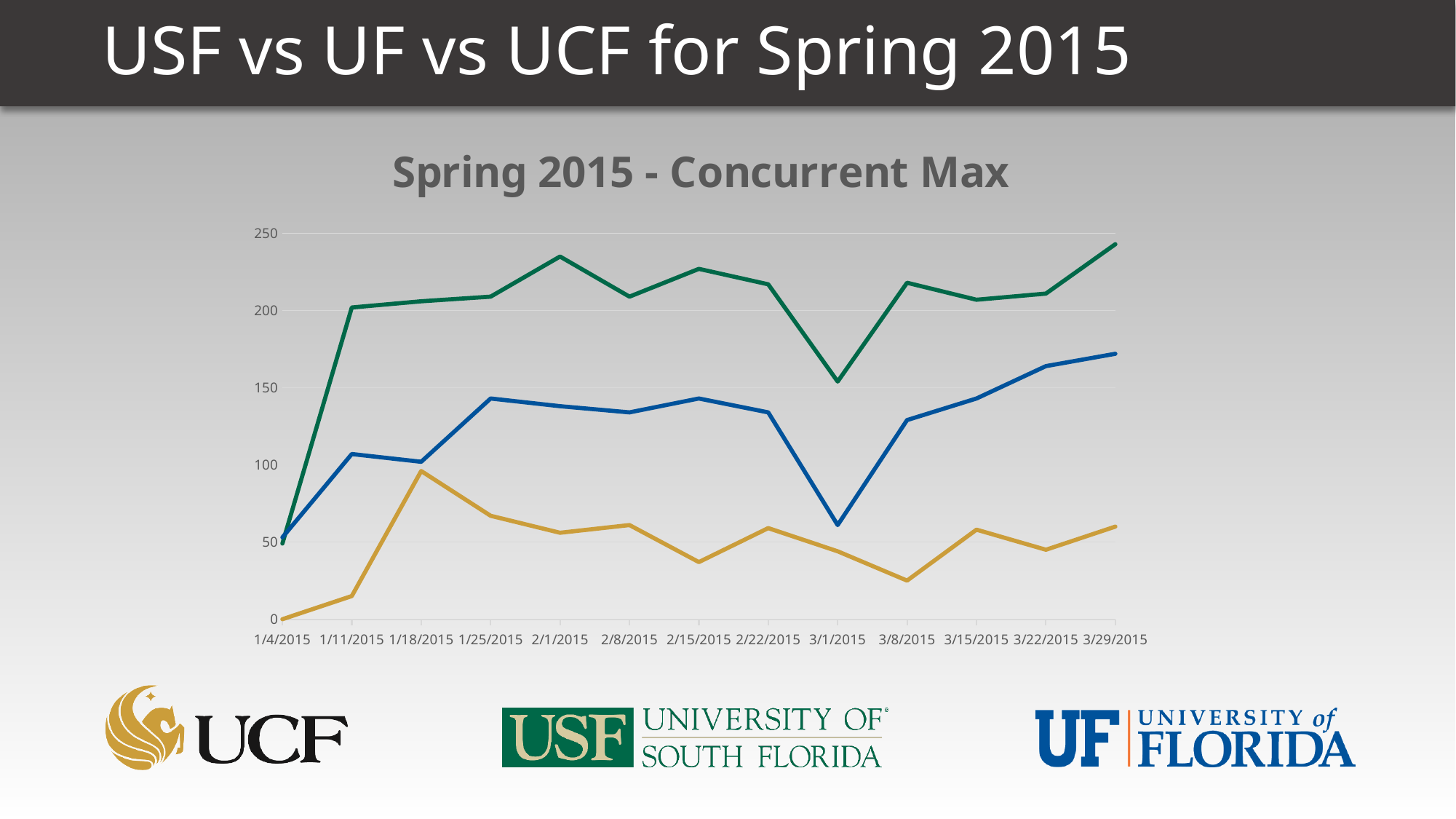
Is the value of the green line at 1/4/2015 greater or less than 100? less On which date is the green line at its lowest value? 1/4/2015 At 2/1/2015, which line has the larger value, the green line or the blue line? green line Is the value of the green line at 3/1/2015 greater or less than 200? less What is the title of the chart? Spring 2015 - Concurrent Max On which date does the gold line reach its highest value? 1/18/2015 Is the value of the gold line at 1/18/2015 greater or less than 50? greater On which date does the blue line reach its highest value? 3/29/2015 What kind of chart is shown on the slide? line chart How many dates are shown along the x axis of the chart? 13 How many lines are plotted on the chart? 3